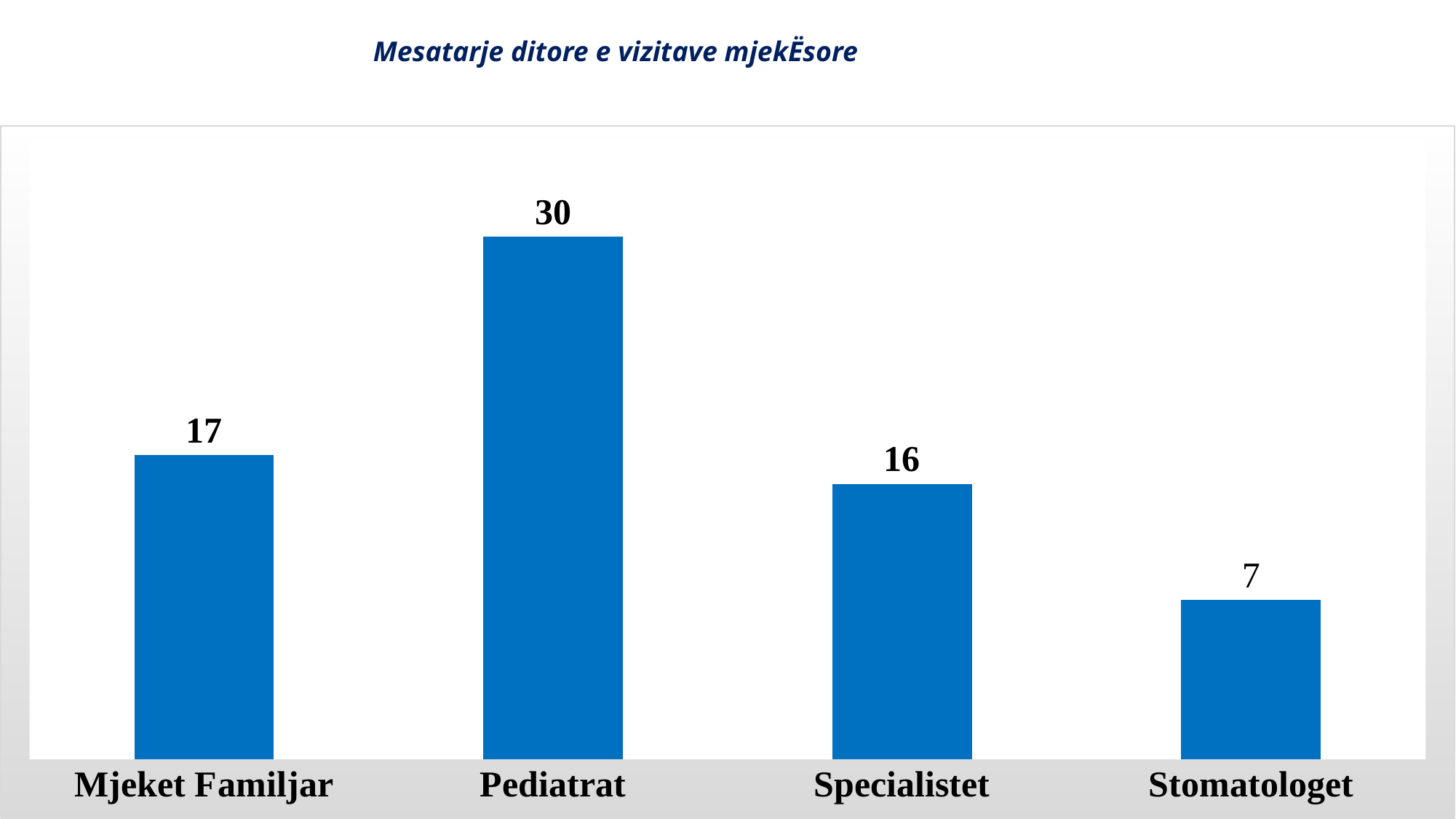
What is the value for Mjeket Familjar? 17 What is the value for Stomatologet? 7 How many categories are shown in the chart? 4 Which category has the lowest value? Stomatologet What is the title of the chart? Mesatarje ditore e vizitave mjekËsore Which is larger, the value for Pediatrat or the value for Mjeket Familjar? Pediatrat What kind of chart is shown on the slide? Bar chart What is the value for Specialistet? 16 What is the value for Pediatrat? 30 What is the difference between the values for Pediatrat and Stomatologet? 23 What is the difference between the values for Mjeket Familjar and Specialistet? 1 Which category has the highest value? Pediatrat